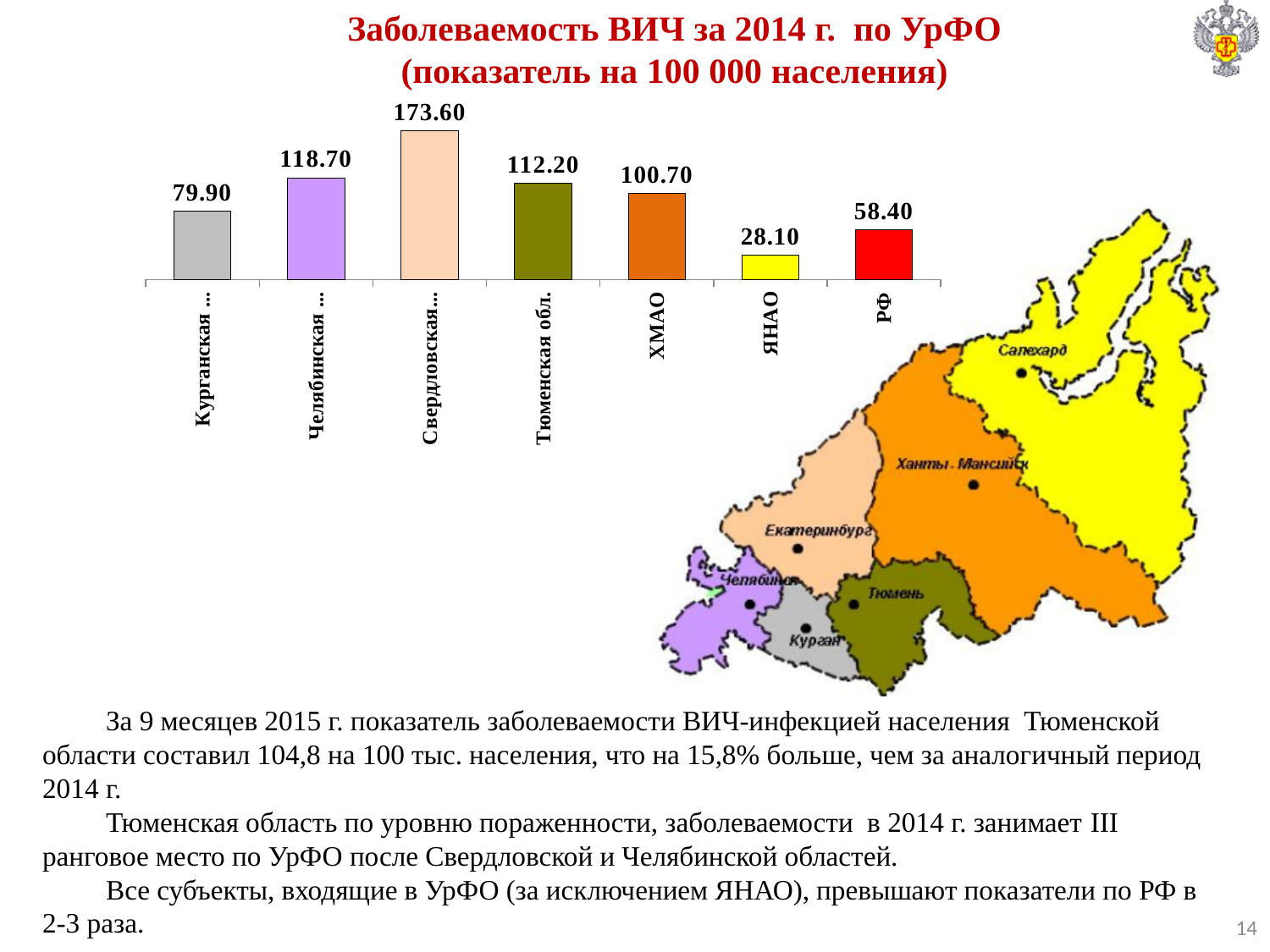
What is the difference between the values for Тюменская обл. and РФ? 53.80 What is the title of the chart? Заболеваемость ВИЧ за 2014 г. по УрФО (показатель на 100 000 населения) How many bars are plotted in the chart? 7 What is the value for ХМАО? 100.70 Which category has the lowest value? ЯНАО What type of chart is shown on the slide? bar chart Which is larger, the value for Курганская or the value for ХМАО? ХМАО What is the value for РФ? 58.40 What is the value for ЯНАО? 28.10 Which category has the highest value? Свердловская What is the difference between the values for Свердловская and Челябинская? 54.90 What is the value for Тюменская обл.? 112.20